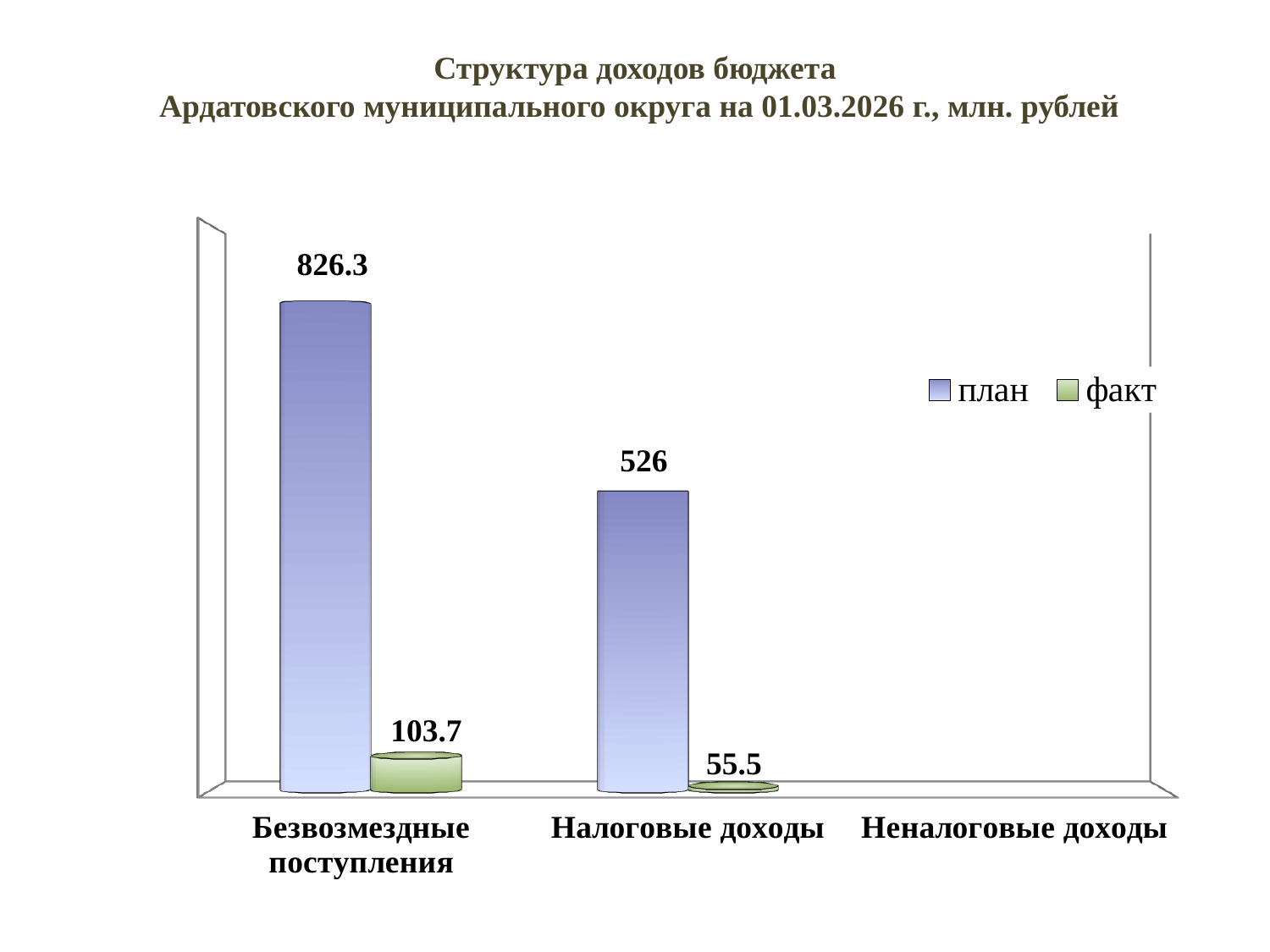
What kind of chart is shown on the slide? Bar chart How many series does the legend list? 2 Which is larger: the факт value for Безвозмездные поступления or the факт value for Налоговые доходы? Безвозмездные поступления Which category has the highest план value? Безвозмездные поступления What is the план value for Безвозмездные поступления? 826.3 What is the план value for Налоговые доходы? 526 What is the факт value for Налоговые доходы? 55.5 What is the difference between the план and факт values for Безвозмездные поступления? 722.6 Which category has the lowest факт value among those with a visible bar? Налоговые доходы What is the факт value for Безвозмездные поступления? 103.7 What is the difference between the план values for Безвозмездные поступления and Налоговые доходы? 300.3 How many categories are shown on the x axis? 3